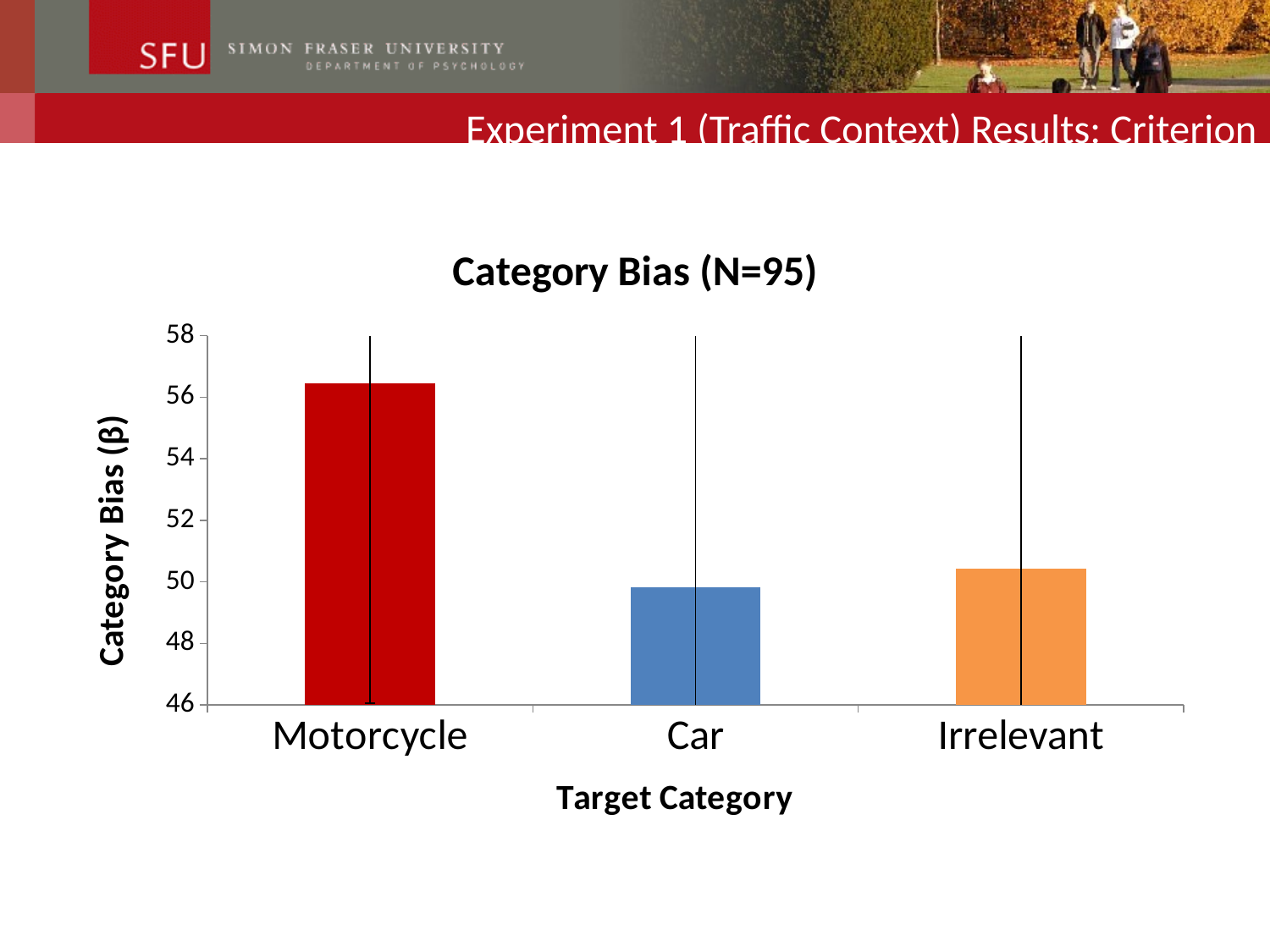
What kind of chart is shown on the slide? bar chart Is the value for Motorcycle greater or less than 54? greater Which target category has the highest category bias? Motorcycle How many target categories are plotted in the chart? 3 Is the value for Car greater or less than 50? less Is the value for Irrelevant greater or less than 52? less What is the title of the chart? Category Bias (N=95) Which target category has the lowest category bias? Car Which has a larger category bias, Motorcycle or Irrelevant? Motorcycle Which has a larger category bias, Motorcycle or Car? Motorcycle What is the label of the x axis of the chart? Target Category